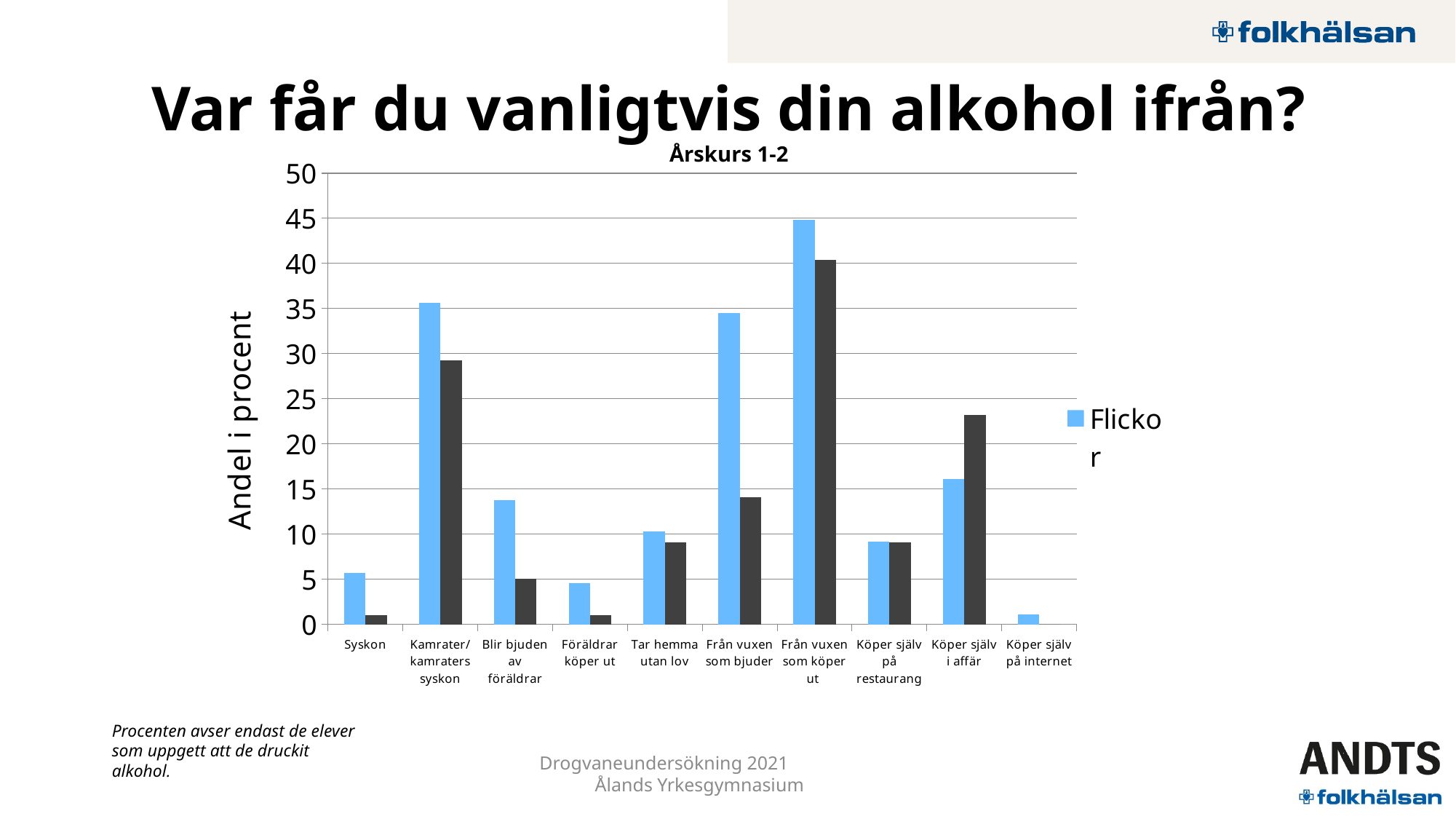
For Flickor, which is larger: Blir bjuden av föräldrar or Tar hemma utan lov? Blir bjuden av föräldrar What is the label of the y axis? Andel i procent How many categories are shown on the x axis of the chart? 10 Is the value for Flickor in Från vuxen som bjuder greater or less than 30? greater Is the value for Flickor in Köper själv i affär greater or less than 20? less What is the title of the chart? Årskurs 1-2 Which category has the lowest value for Flickor? Köper själv på internet Which category has the highest value for Flickor? Från vuxen som köper ut Is the value for Flickor in Syskon greater or less than 10? less What kind of chart is shown on the slide? bar chart